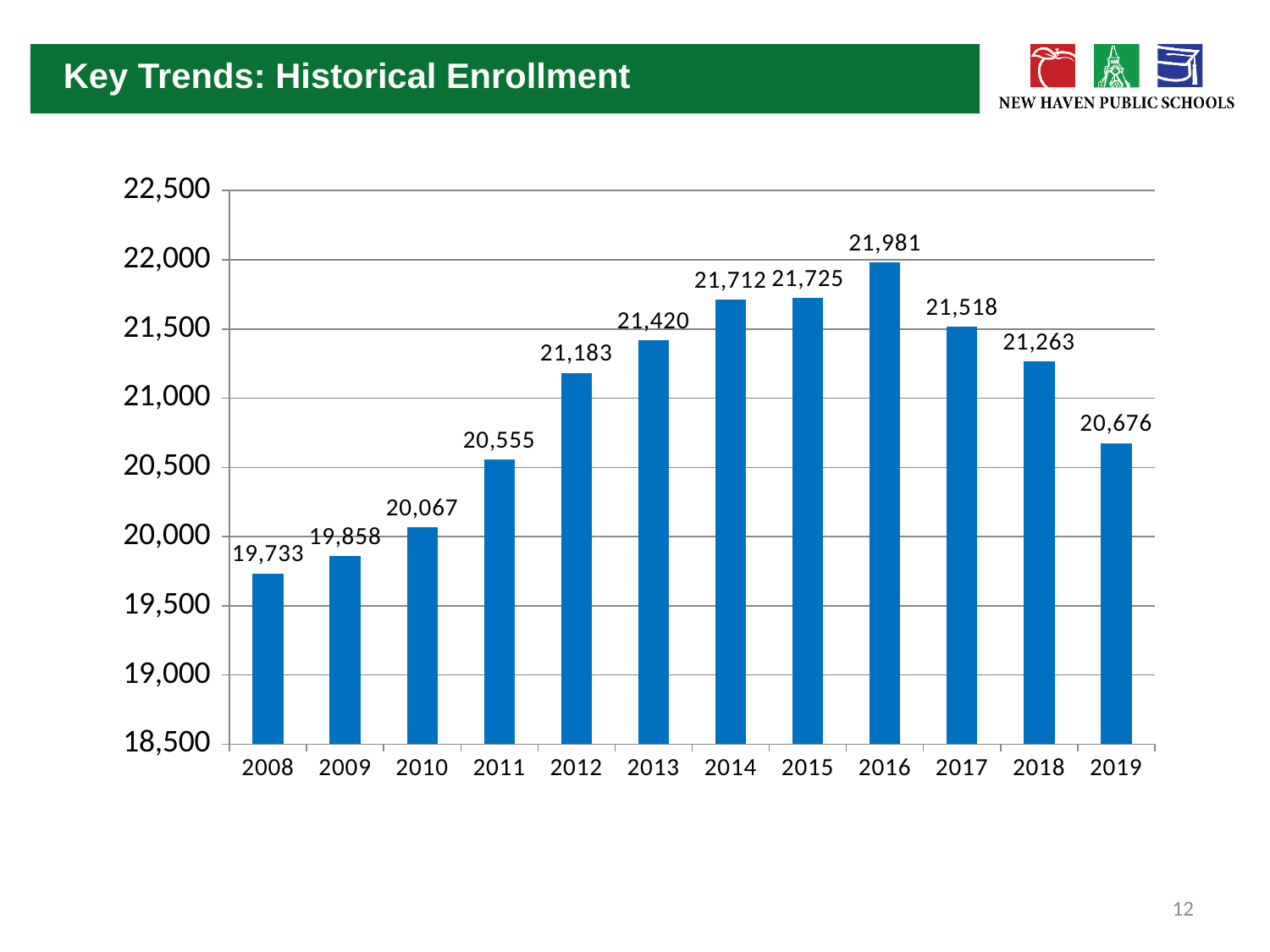
What is the difference in enrollment between 2009 and 2008? 125 What was the enrollment in 2008? 19,733 Which year had the highest enrollment? 2016 What is the difference in enrollment between 2016 and 2019? 1,305 Is the enrollment for 2011 greater or less than 21,000? less Did enrollment rise or fall from 2016 to 2019? fall What kind of chart is shown on the slide? bar chart How many years are shown on the chart? 12 What was the enrollment in 2012? 21,183 What was the enrollment in 2019? 20,676 Which year had the lowest enrollment? 2008 Which year had higher enrollment, 2013 or 2017? 2017